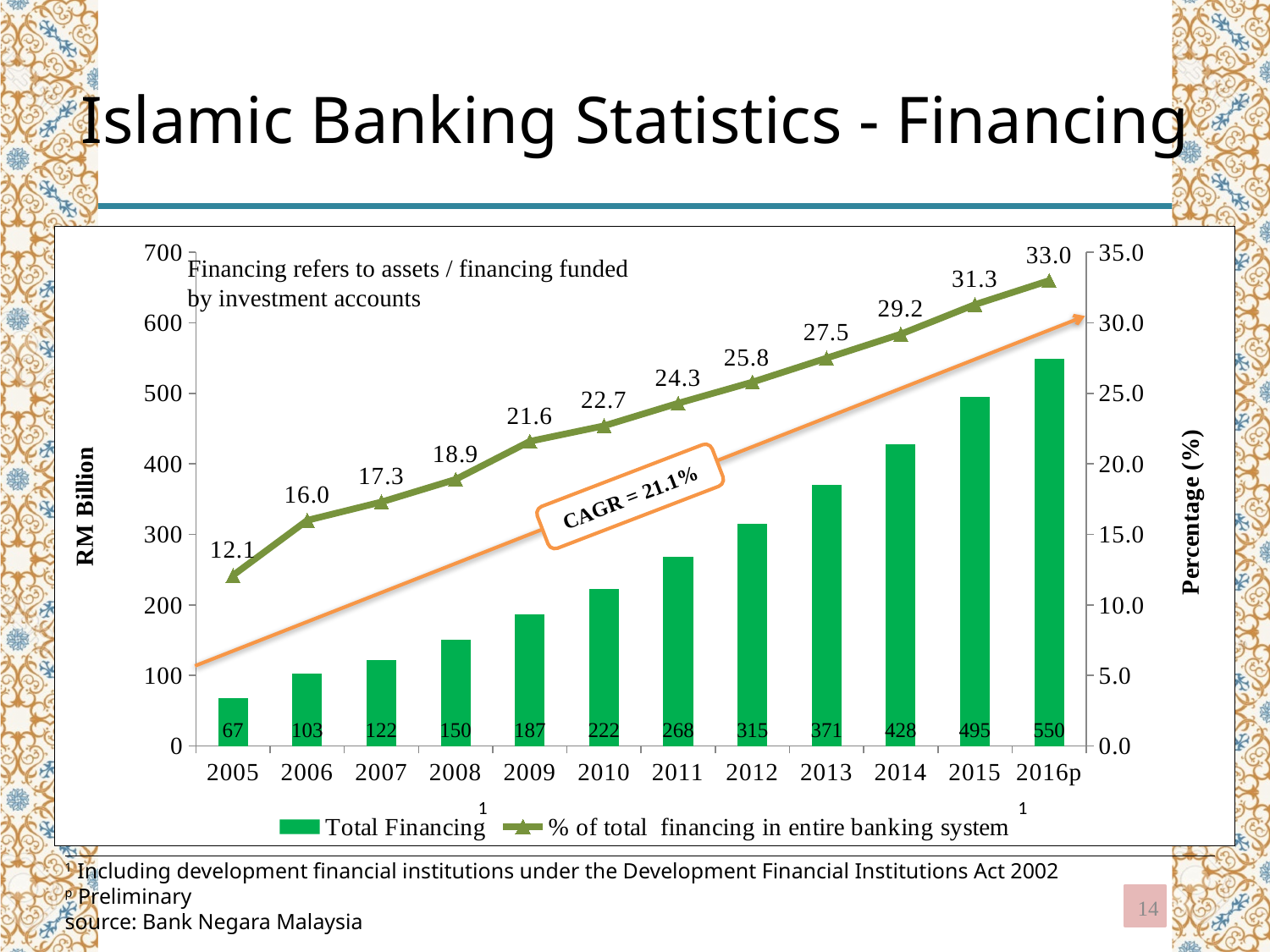
How many years are shown on the x axis? 12 What is the difference in Total Financing between 2015 and 2014? 67 Which is larger, the Total Financing for 2008 or for 2009? 2009 Which year has the lowest Total Financing? 2005 What is the Total Financing value for 2010? 222 How many series does the legend list? 2 Do the Total Financing values rise or fall from 2005 to 2016p? rise What CAGR is stated on the chart? 21.1% What kind of chart is used for the Total Financing series? bar chart Which year has the highest % of total financing in entire banking system? 2016p What is the Total Financing value for 2016p? 550 What is the % of total financing in entire banking system for 2013? 27.5